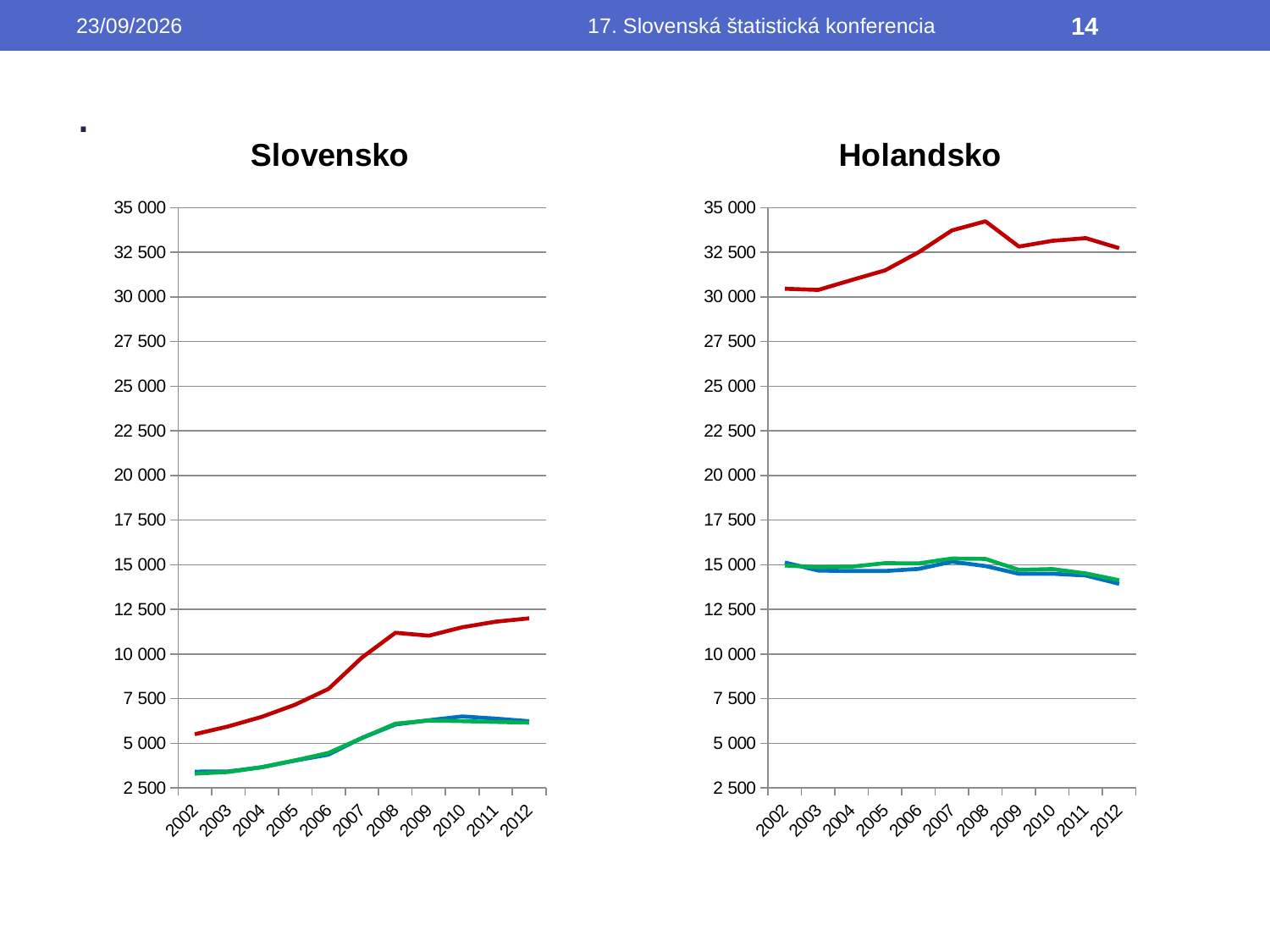
In the Slovensko chart, does the red line rise or fall from 2002 to 2012? rise In the Holandsko chart, is the value of the blue line in 2012 greater or less than 15 000? less In the Holandsko chart, in which year does the red line reach its highest value? 2008 In the Slovensko chart, is the value of the green line in 2002 greater or less than 5 000? less In the Slovensko chart, is the value of the red line in 2012 greater or less than 10 000? greater How many lines are plotted on the Slovensko chart? 3 How many years are shown on the x axis of the Holandsko chart? 11 In the Slovensko chart, in which year does the red line reach its lowest value? 2002 What kind of chart is the Slovensko chart? line chart In the Slovensko chart, does the green line rise or fall from 2002 to 2008? rise Which chart has the higher value for the red line in 2012, Slovensko or Holandsko? Holandsko